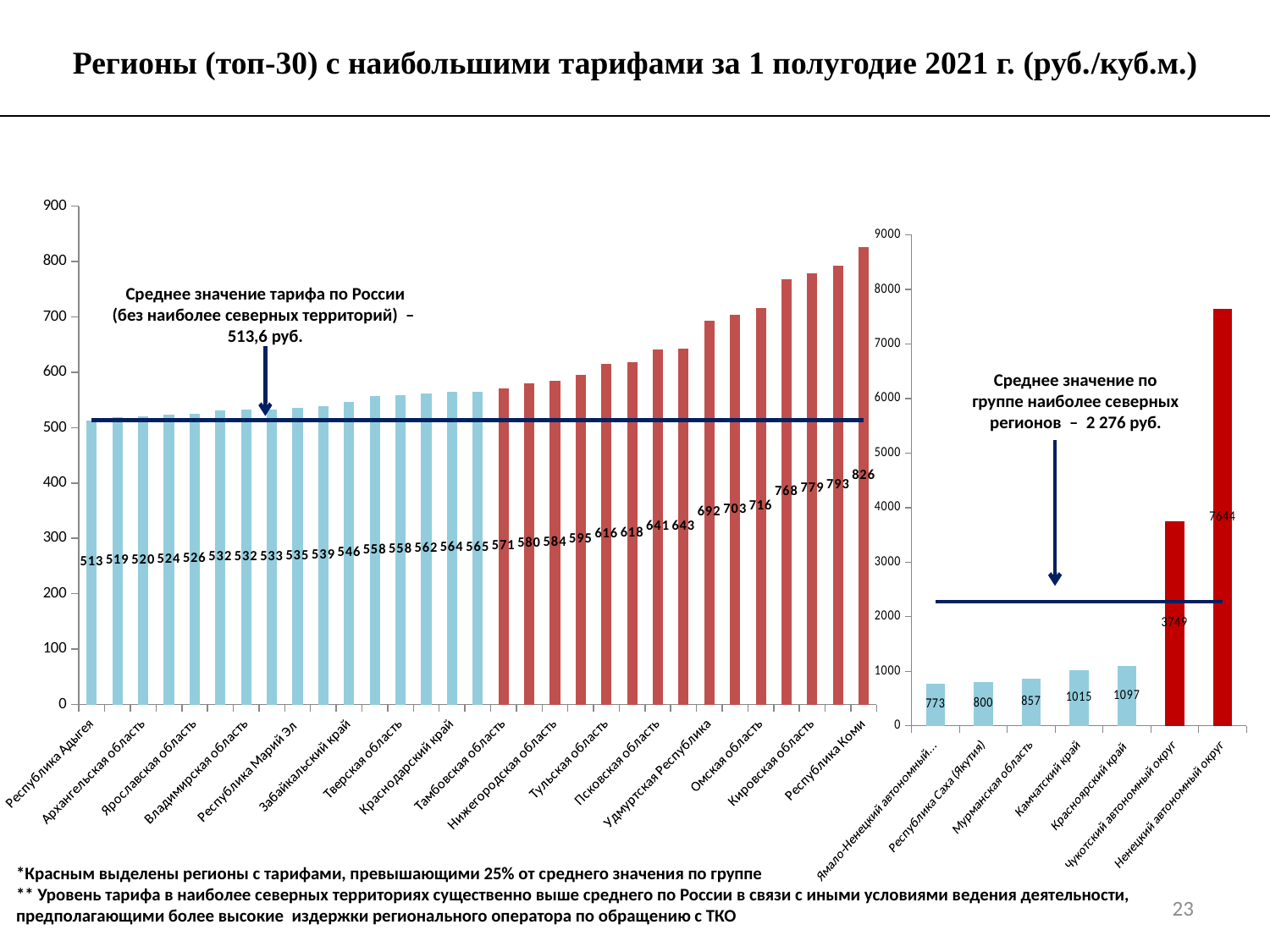
In the right chart of the most northern regions, what is the difference between Ненецкий автономный округ and Чукотский автономный округ? 3895 In the right chart of the most northern regions, what is the value for Ненецкий автономный округ? 7644 What kind of chart is the left chart showing the top-30 regions? bar chart In the left chart of the top-30 regions, what is the value for Республика Коми? 826 In the right chart of the most northern regions, how many regions are shown? 7 According to the annotation on the left chart, what is the average tariff in Russia excluding the most northern territories? 513,6 руб. In the right chart of the most northern regions, which is larger: Красноярский край or Мурманская область? Красноярский край In the left chart of the top-30 regions, what is the value for Республика Адыгея? 513 In the right chart of the most northern regions, what is the value for Камчатский край? 1015 In the right chart of the most northern regions, which region has the lowest value? Ямало-Ненецкий автономный округ In the left chart of the top-30 regions, do the values rise or fall from left to right? rise In the right chart of the most northern regions, which region has the highest value? Ненецкий автономный округ